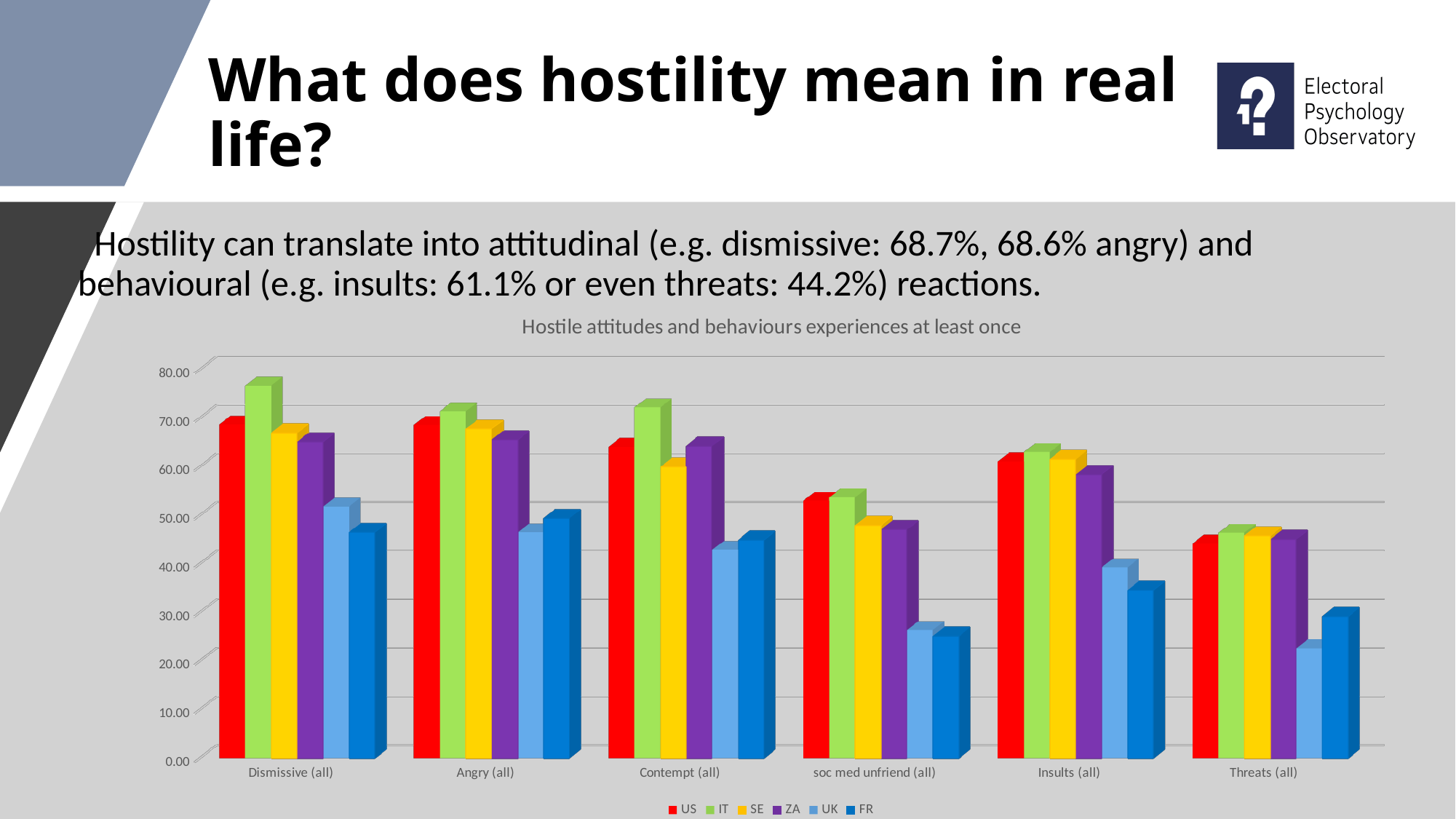
How many series does the chart legend list? 6 Which country has the highest value for Contempt (all)? IT Is the value for IT in Dismissive (all) greater or less than 70? greater Is the value for UK in soc med unfriend (all) greater or less than 30? less How many categories are shown along the x axis of the chart? 6 Is the value for US in Threats (all) greater or less than 40? greater What type of chart is shown on the slide? Bar chart Which country has the lowest value for Threats (all)? UK Which colour represents the US series in the chart? Red Which country has the highest value for Dismissive (all)? IT What is the title of the chart? Hostile attitudes and behaviours experiences at least once Which is larger: the ZA value for Angry (all) or the ZA value for soc med unfriend (all)? Angry (all)